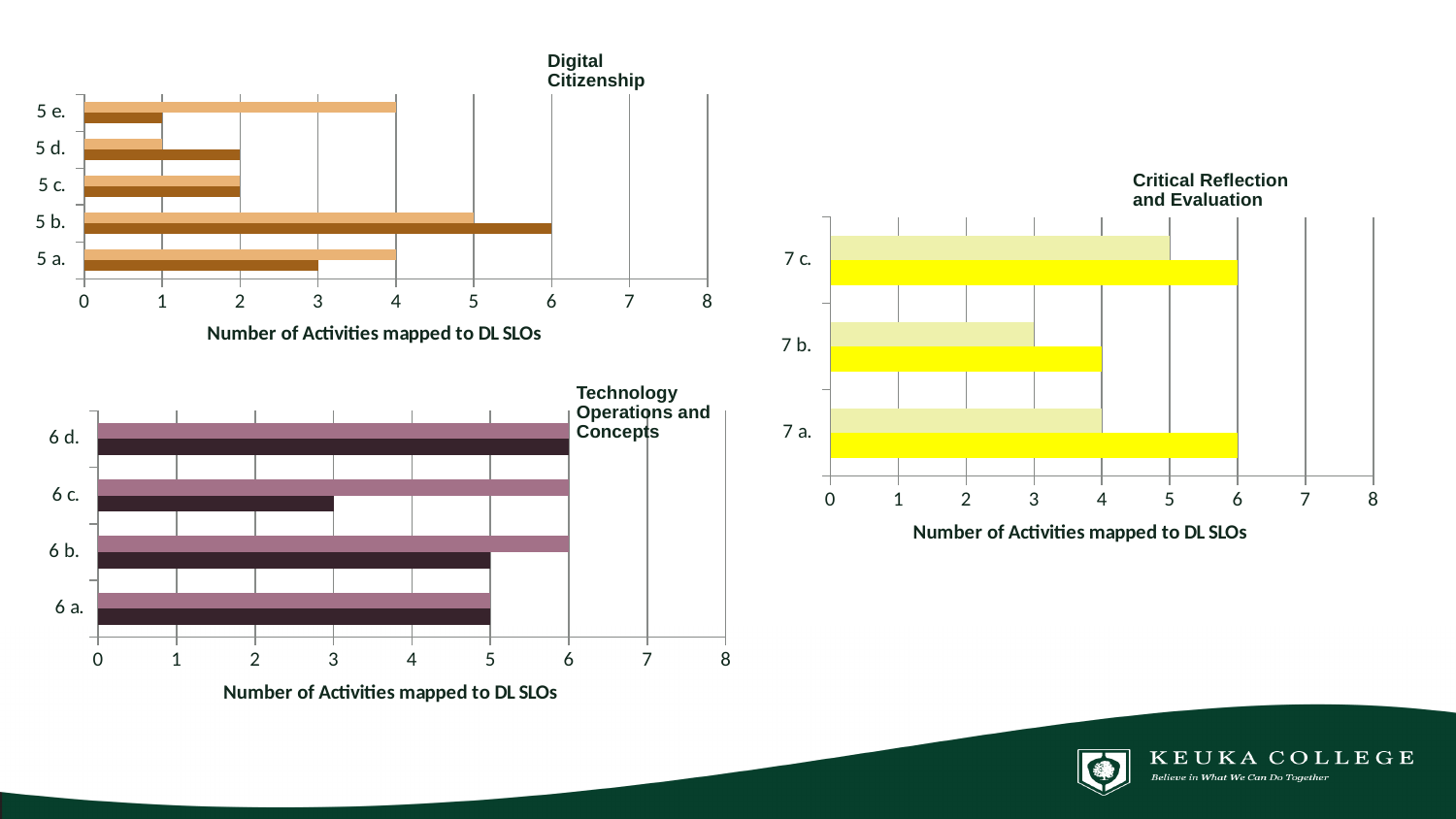
What type of chart is the Critical Reflection and Evaluation chart? bar chart In the Digital Citizenship chart, which category has the longest dark orange bar? 5 b. In the Digital Citizenship chart, what is the value of the light orange bar for 5 e.? 4 In the Technology Operations and Concepts chart, what is the difference between the light pink bar and the dark bar for 6 c.? 3 In the Digital Citizenship chart, how many categories are shown on the vertical axis? 5 In the Technology Operations and Concepts chart, how many categories are shown? 4 In the Critical Reflection and Evaluation chart, what is the value of the bright yellow bar for 7 b.? 4 In the Critical Reflection and Evaluation chart, which category has the shortest pale yellow bar? 7 b. In the Critical Reflection and Evaluation chart, is the bright yellow bar for 7 a. larger or smaller than the bright yellow bar for 7 b.? larger What is the horizontal axis title of the Digital Citizenship chart? Number of Activities mapped to DL SLOs In the Technology Operations and Concepts chart, what is the value of the dark bar for 6 c.? 3 In the Digital Citizenship chart, what is the value of the dark orange bar for 5 b.? 6